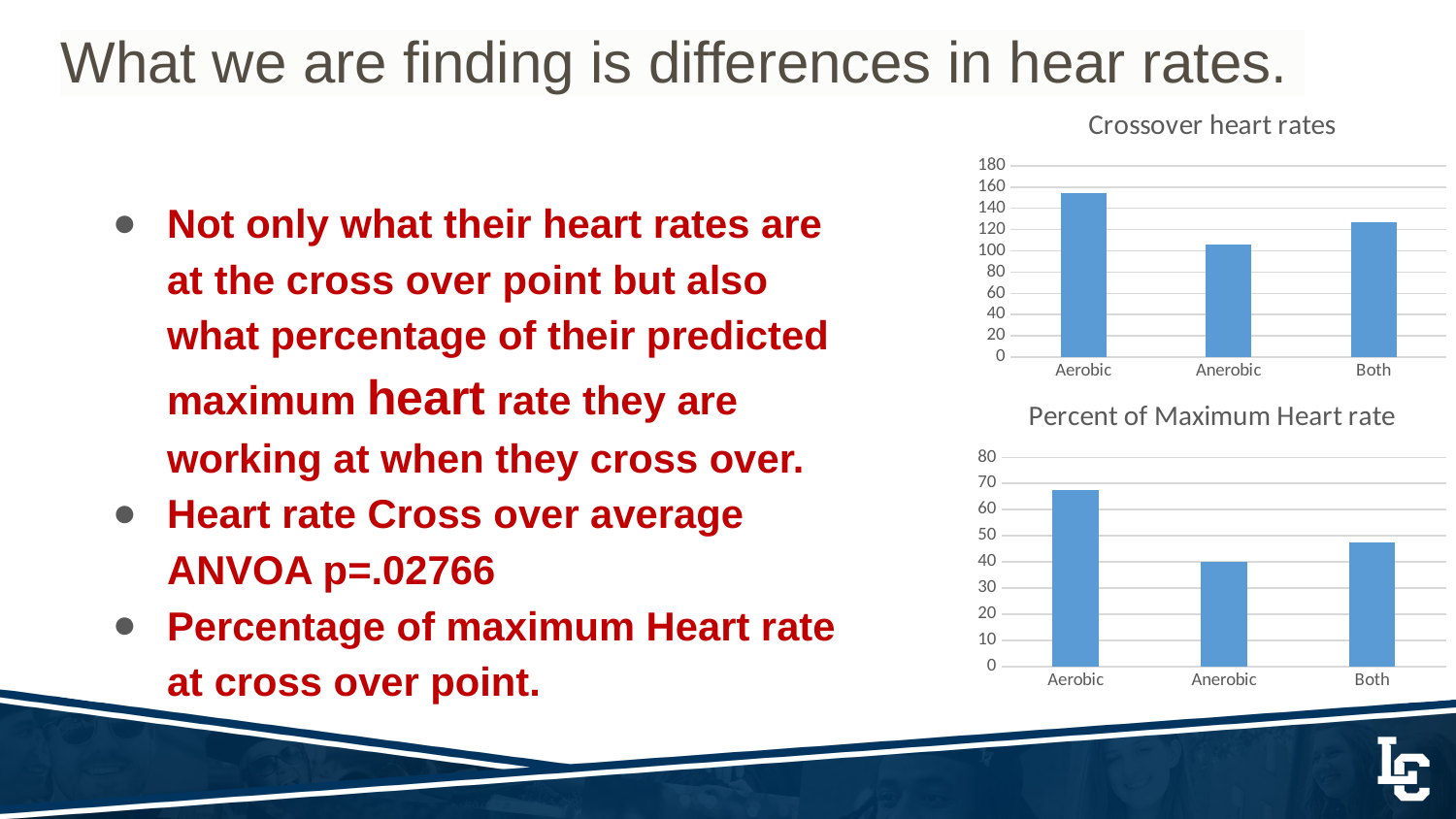
In the 'Crossover heart rates' chart, is the value for Anerobic greater or less than 120? less In the 'Crossover heart rates' chart, is the value for Aerobic greater or less than 140? greater In the 'Percent of Maximum Heart rate' chart, which category has the highest value? Aerobic What kind of chart is the 'Crossover heart rates' chart? bar chart In the 'Percent of Maximum Heart rate' chart, which is larger, the value for Both or the value for Anerobic? Both In the 'Crossover heart rates' chart, which category has the highest value? Aerobic In the 'Crossover heart rates' chart, is the value for Both greater or less than 140? less In the 'Crossover heart rates' chart, which category has the lowest value? Anerobic What is the title of the lower chart on the slide? Percent of Maximum Heart rate How many categories are shown on the 'Crossover heart rates' chart? 3 In the 'Percent of Maximum Heart rate' chart, which category has the lowest value? Anerobic